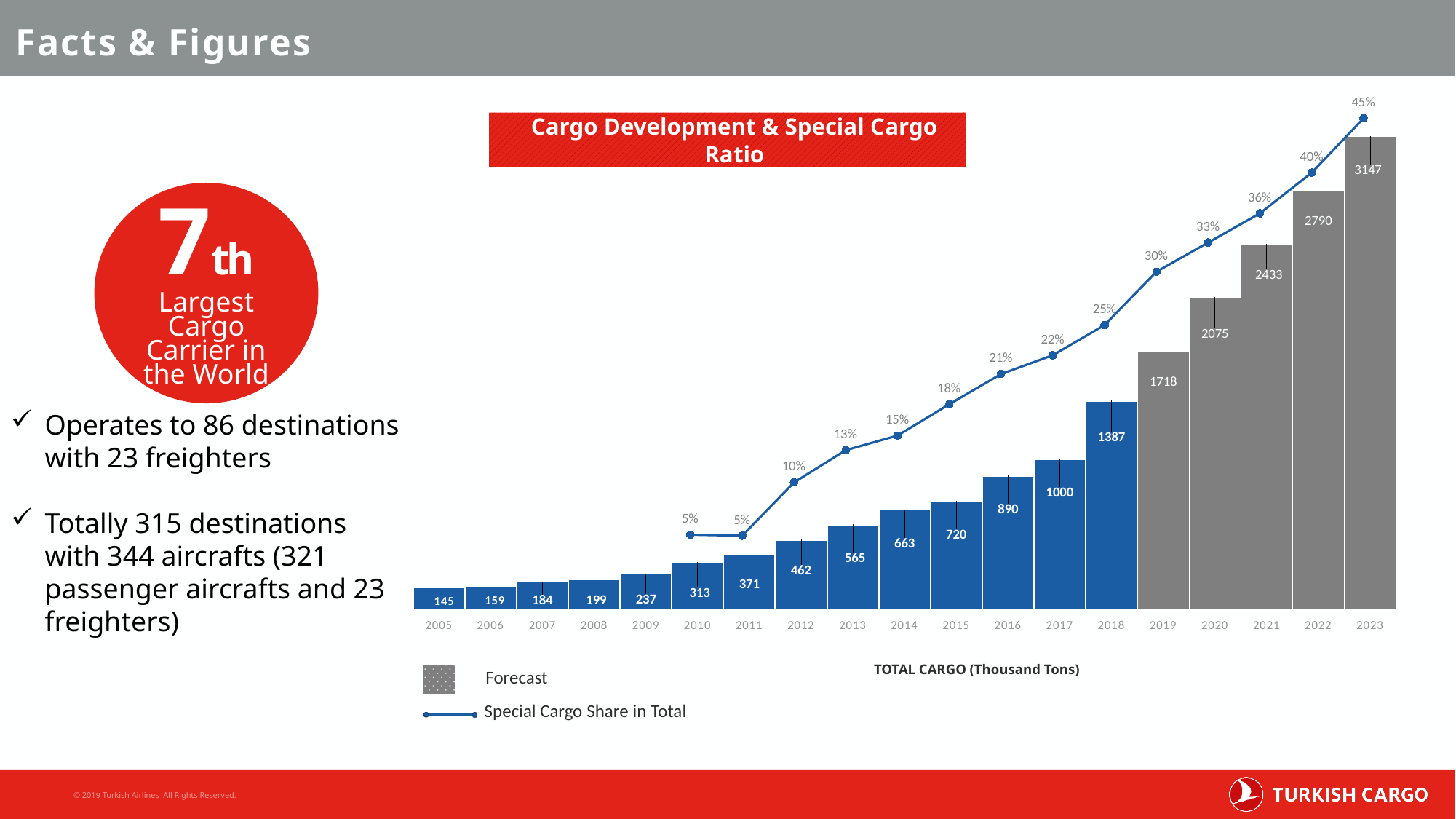
What is the Special Cargo Share in Total for 2015? 18% Which year has the highest Special Cargo Share in Total? 2023 What unit is total cargo measured in according to the chart? Thousand Tons What kind of chart is used to show total cargo? Bar chart What is the difference in total cargo between 2018 and 2017? 387 How many years are shown on the x axis? 19 Which year has a larger total cargo value, 2012 or 2014? 2014 Does the Special Cargo Share in Total rise or fall from 2010 to 2023? Rise What is the title of the chart? Cargo Development & Special Cargo Ratio Which year has the lowest total cargo value? 2005 What is the total cargo value for 2018? 1387 What is the forecast total cargo value for 2023? 3147